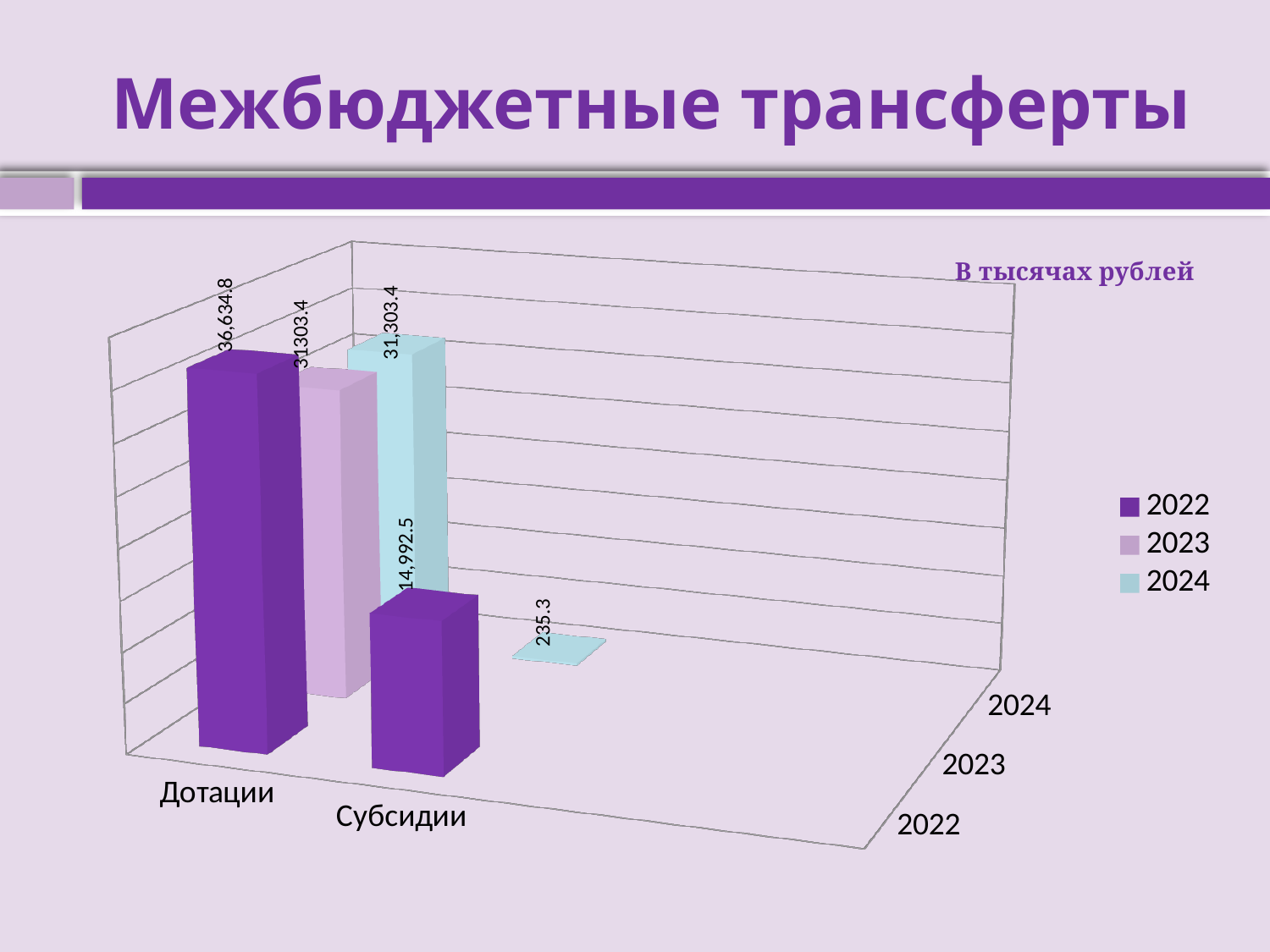
What is the value for Субсидии in 2024? 235.3 What is the value for Субсидии in 2022? 14,992.5 Which bar has the highest value on the chart? Дотации, 2022 Which is larger in 2022: Дотации or Субсидии? Дотации What is the value for Дотации in 2022? 36,634.8 What is the difference between Субсидии in 2022 and Субсидии in 2024? 14,757.2 What is the difference between Дотации in 2022 and Дотации in 2024? 5,331.4 In what units are the values on the chart given, according to the label on the slide? В тысячах рублей Which bar has the lowest value on the chart? Субсидии, 2024 What kind of chart is shown on the slide? Bar chart How many series does the legend list? 3 What is the value for Дотации in 2024? 31,303.4